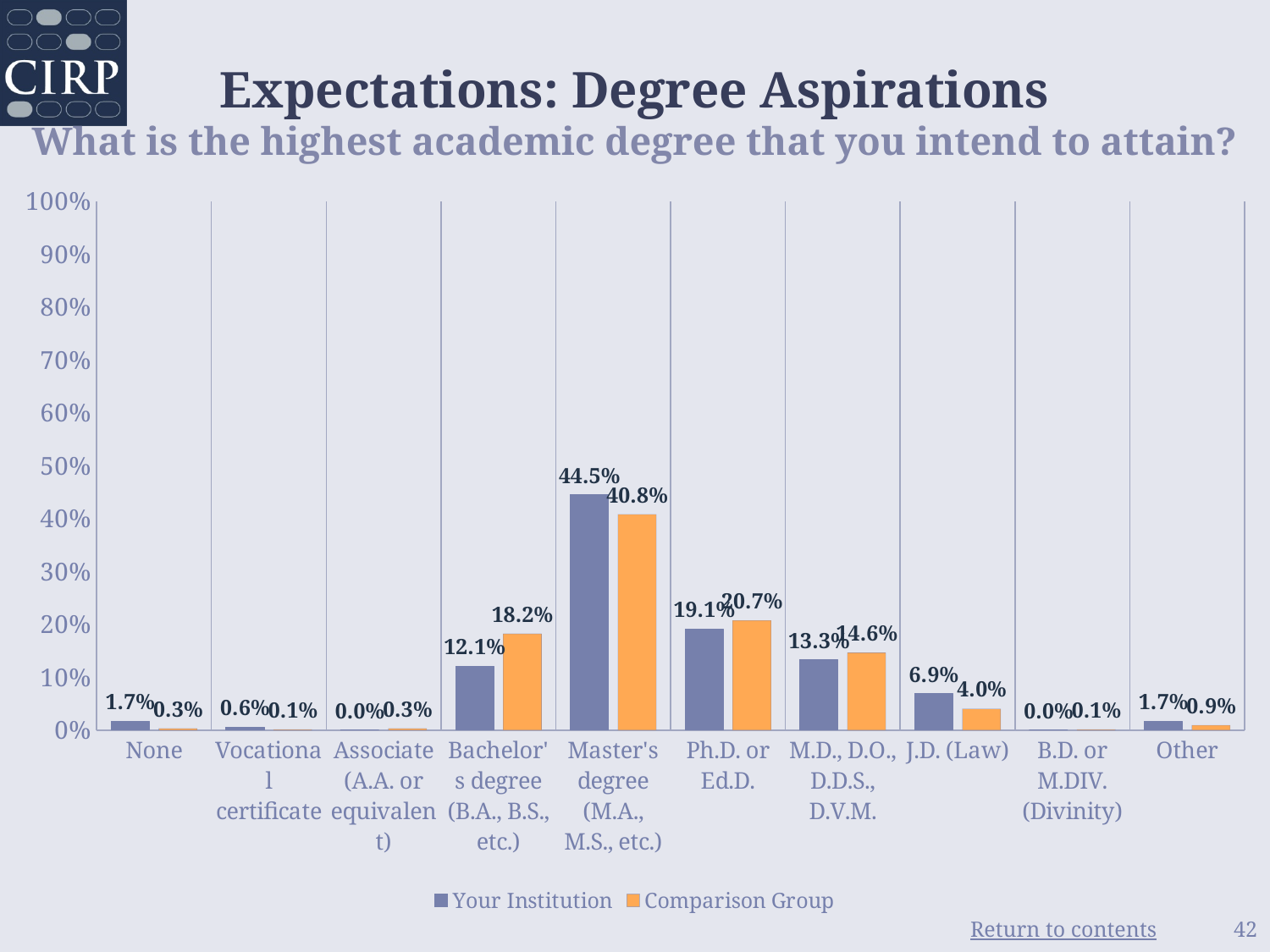
What kind of chart is shown on the slide? Bar chart How many degree categories are shown on the x axis? 10 What is the Your Institution value for Master's degree (M.A., M.S., etc.)? 44.5% What is the difference between the Your Institution and Comparison Group values for Master's degree (M.A., M.S., etc.)? 3.7% Which degree category has the highest Your Institution value? Master's degree (M.A., M.S., etc.) What is the Comparison Group value for Bachelor's degree (B.A., B.S., etc.)? 18.2% For M.D., D.O., D.D.S., D.V.M., which is larger: Your Institution or Comparison Group? Comparison Group What is the difference between the Comparison Group and Your Institution values for Bachelor's degree (B.A., B.S., etc.)? 6.1% How many series does the legend list? 2 What is the Comparison Group value for Ph.D. or Ed.D.? 20.7% What is the Your Institution value for J.D. (Law)? 6.9% For J.D. (Law), which is larger: Your Institution or Comparison Group? Your Institution